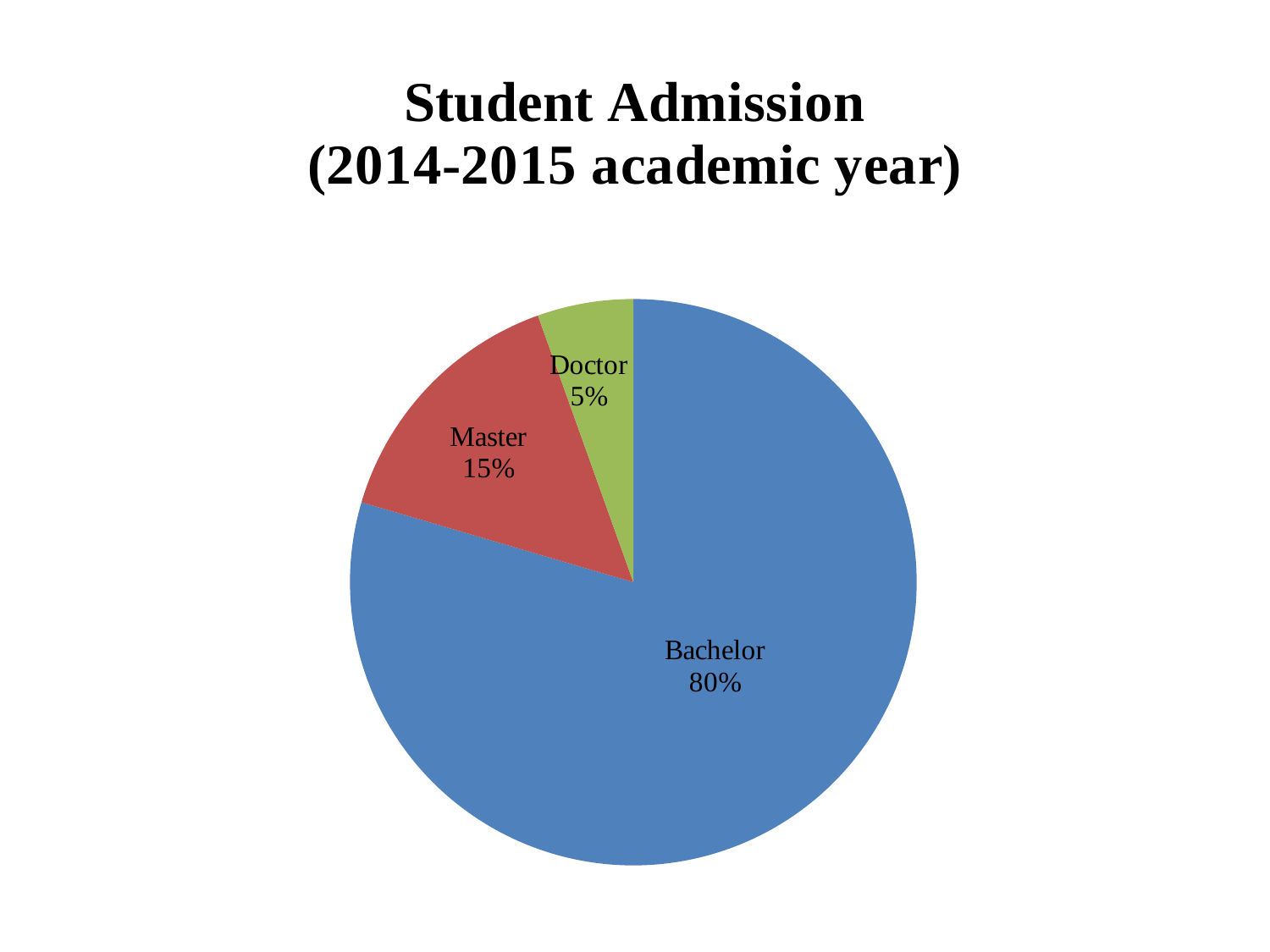
Which is larger, the Master share or the Doctor share? Master Which category has the largest share of the pie? Bachelor What kind of chart is shown on the slide? pie chart What is the difference in percentage points between the Master and Doctor shares? 10 What share of student admissions is Bachelor? 80% What share of student admissions is Master? 15% How many categories are shown in the pie chart? 3 What is the title of the chart? Student Admission (2014-2015 academic year) Which category has the smallest share of the pie? Doctor What share of student admissions is Doctor? 5% What colour is the Bachelor slice? blue What is the difference in percentage points between the Bachelor and Master shares? 65